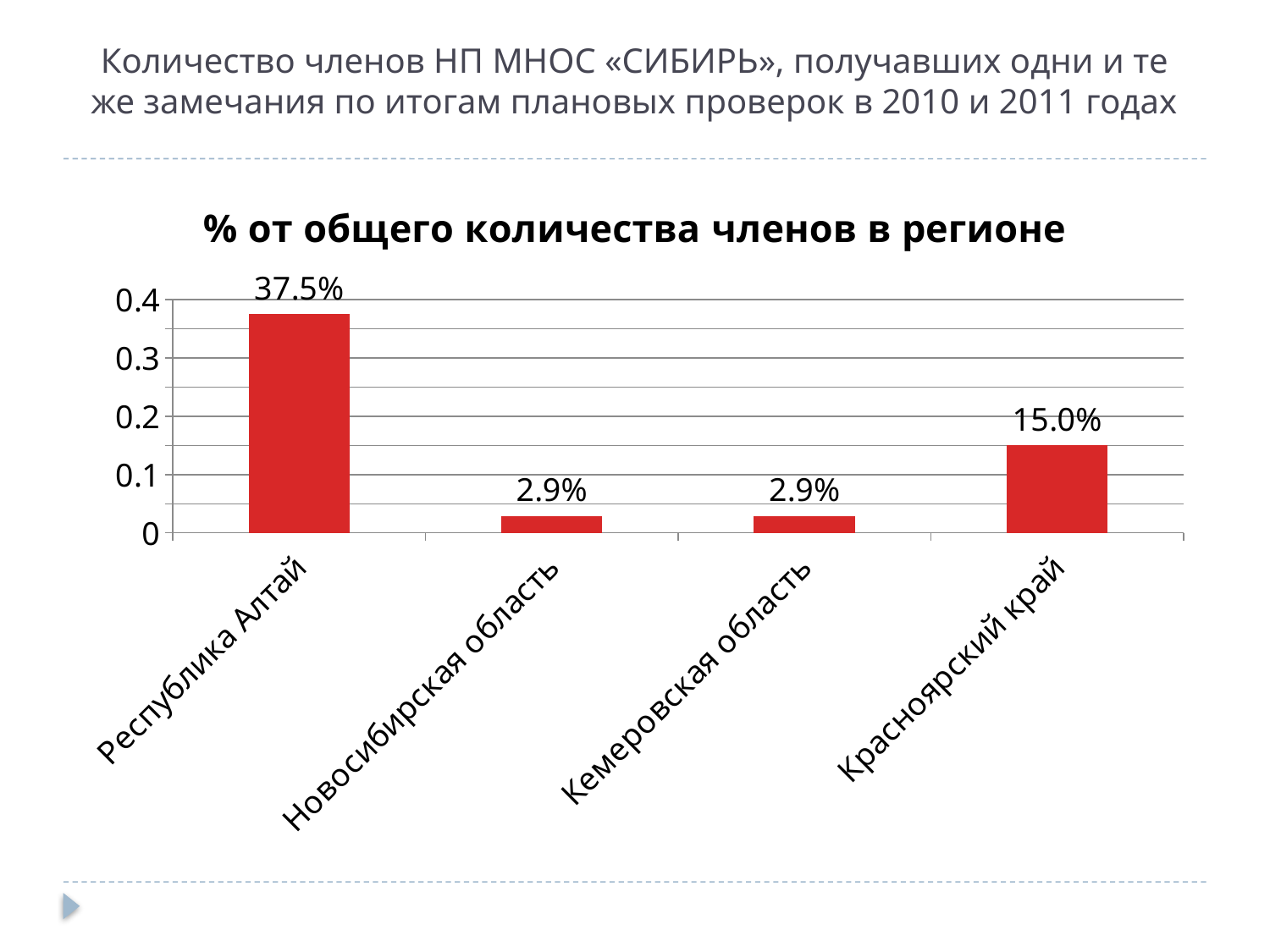
How many regions are shown on the chart? 4 What is the value for Республика Алтай? 37.5% What is the title of the chart? % от общего количества членов в регионе What is the value for Новосибирская область? 2.9% Is the value for Республика Алтай greater or less than 0.3 on the axis? greater Is the value for Кемеровская область greater or less than 0.1 on the axis? less What is the difference between the values for Республика Алтай and Красноярский край? 22.5% Which region has the highest value? Республика Алтай What is the difference between the values for Красноярский край and Кемеровская область? 12.1% Which is larger, the value for Красноярский край or the value for Новосибирская область? Красноярский край What kind of chart is shown on the slide? Bar chart What is the value for Красноярский край? 15.0%